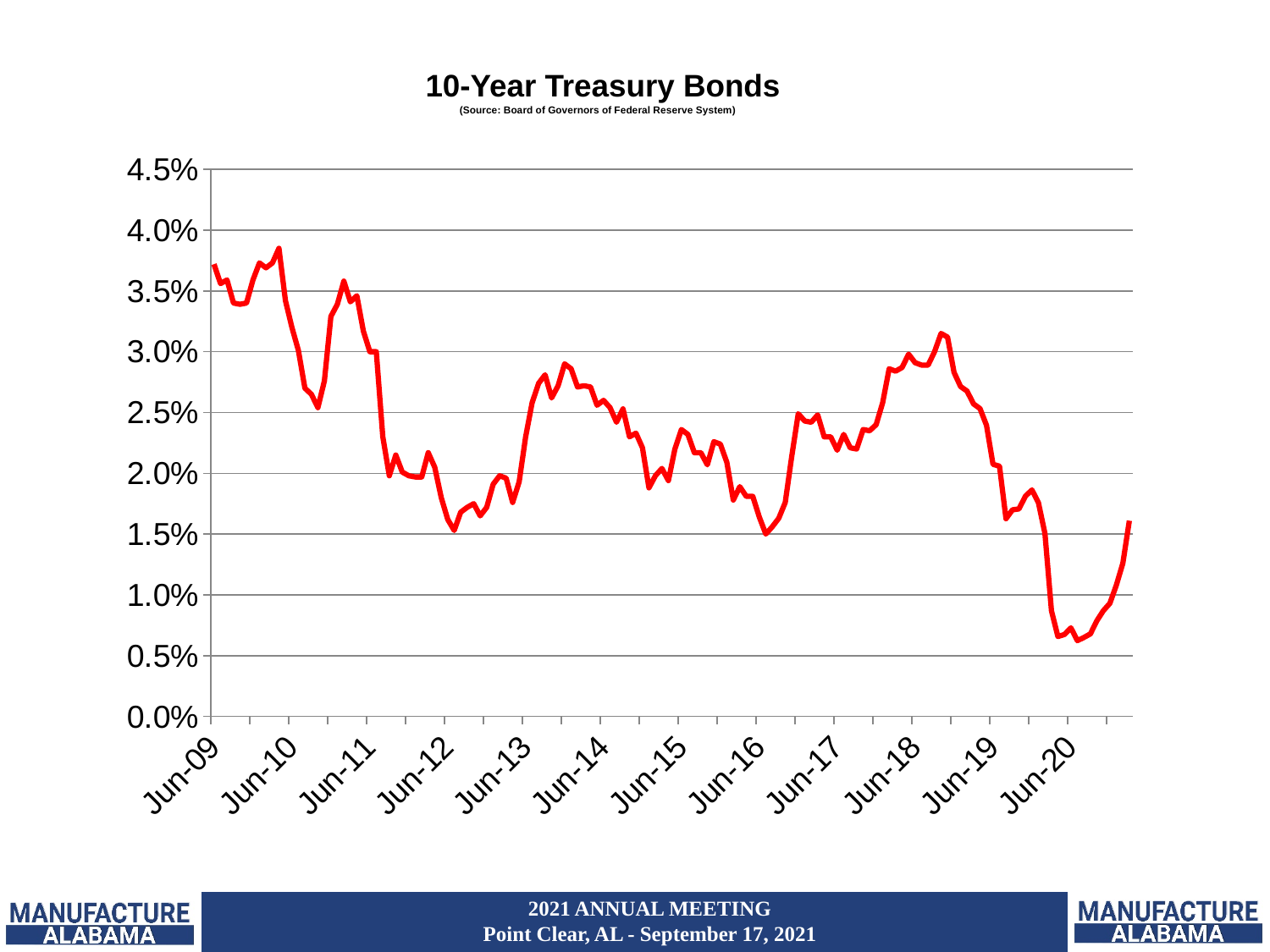
How many date labels are shown on the x axis? 12 What source is cited for the chart? Board of Governors of Federal Reserve System What is the title of the chart? 10-Year Treasury Bonds Is the value at Jun-09 greater or less than 3.5%? greater Near which x-axis label does the line reach its lowest point? Jun-20 Overall, does the 10-year Treasury bond rate rise or fall from Jun-09 to Jun-20? fall Which is larger, the value at Jun-09 or the value at Jun-20? Jun-09 Is the value at Jun-20 greater or less than 1.0%? less What kind of chart is shown on the slide? line chart Is the value at Jun-15 greater or less than 2.0%? greater